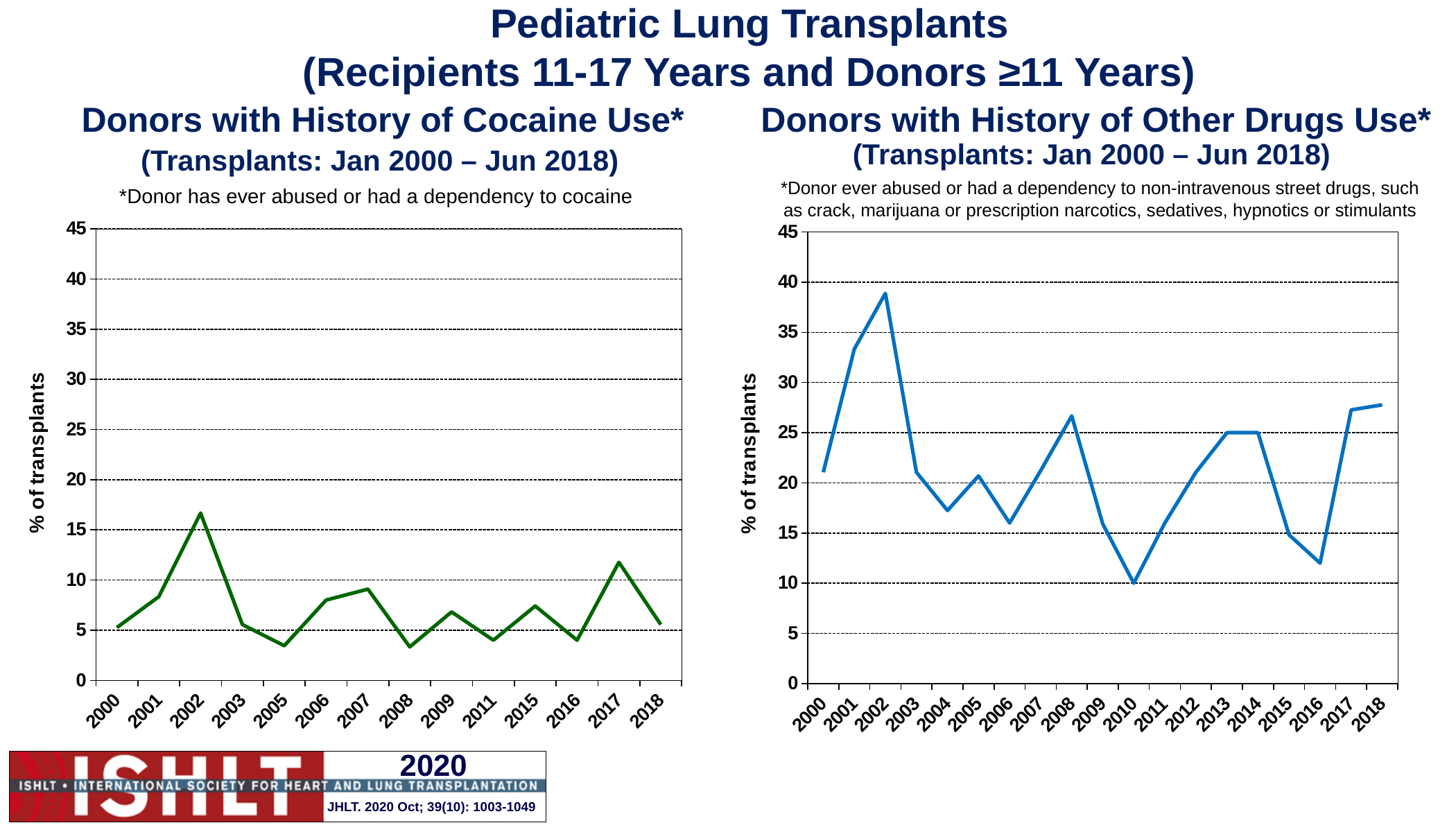
In the 'Donors with History of Cocaine Use' chart on the left, which year has the highest value? 2002 In the 'Donors with History of Other Drugs Use' chart on the right, is the value for 2002 greater or less than 35? greater In the 'Donors with History of Other Drugs Use' chart on the right, which year has the highest value? 2002 In the 'Donors with History of Cocaine Use' chart on the left, is the value for 2002 greater or less than 15? greater In the 'Donors with History of Other Drugs Use' chart on the right, is the value for 2010 greater or less than 15? less What kind of chart is the 'Donors with History of Cocaine Use' chart on the left? line chart What is the y-axis label of the 'Donors with History of Other Drugs Use' chart on the right? % of transplants How many years are plotted on the x axis of the 'Donors with History of Other Drugs Use' chart on the right? 19 In the 'Donors with History of Cocaine Use' chart on the left, which year has the larger value, 2002 or 2017? 2002 How many years are plotted on the x axis of the 'Donors with History of Cocaine Use' chart on the left? 14 In the 'Donors with History of Other Drugs Use' chart on the right, which year has the larger value, 2002 or 2010? 2002 In the 'Donors with History of Other Drugs Use' chart on the right, which year has the lowest value? 2010